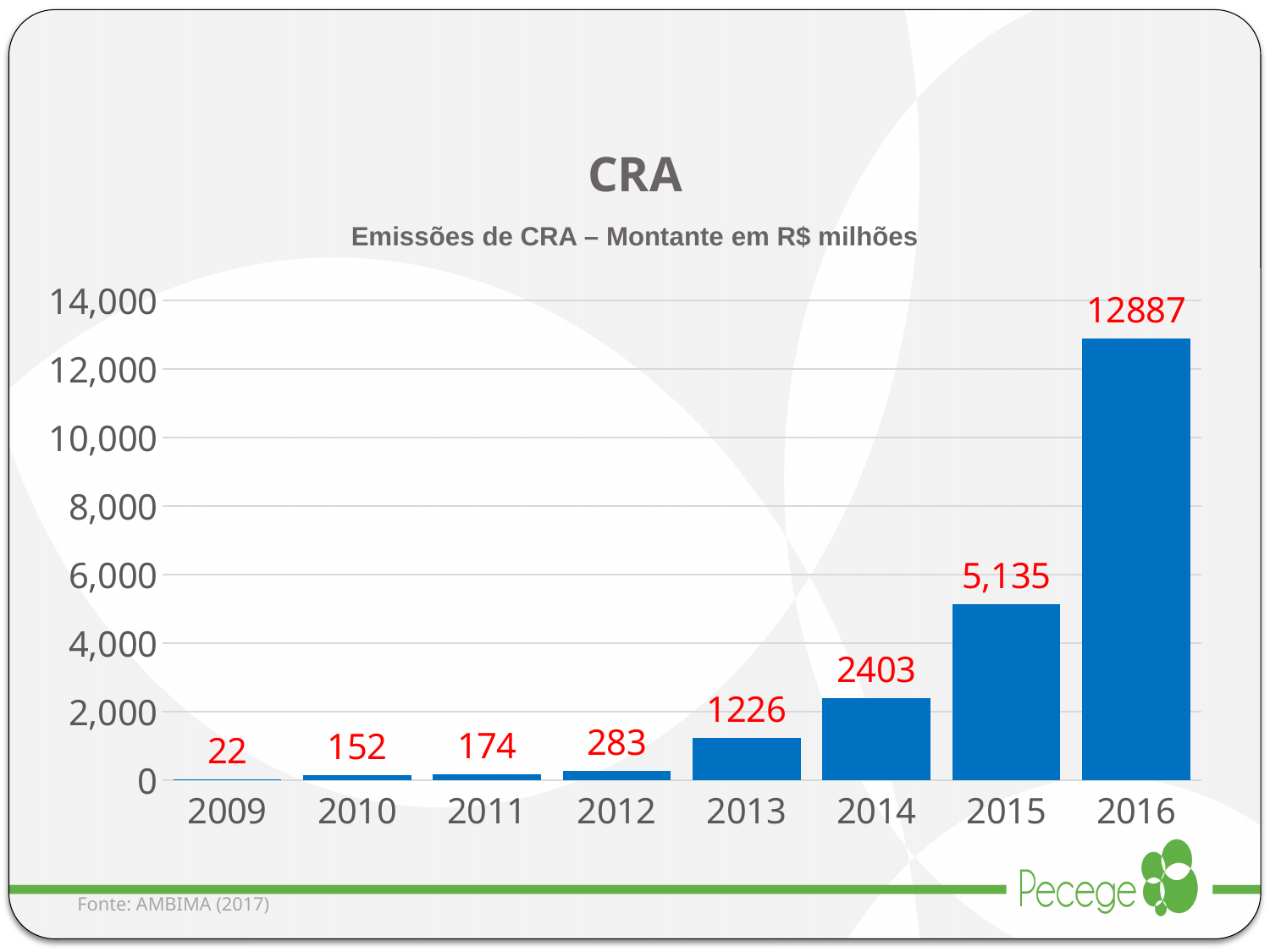
Which year has the lowest value? 2009 Which is larger, the value for 2011 or the value for 2012? 2012 What is the value for 2015? 5,135 How many years are shown on the x axis? 8 What kind of chart is shown? bar chart What is the value for 2016? 12887 What is the value for 2013? 1226 Is the value for 2016 greater or less than 12,000? greater Do the values rise or fall from 2009 to 2016? rise Which year has the highest value? 2016 What is the value for 2009? 22 What is the difference between the values for 2014 and 2013? 1177